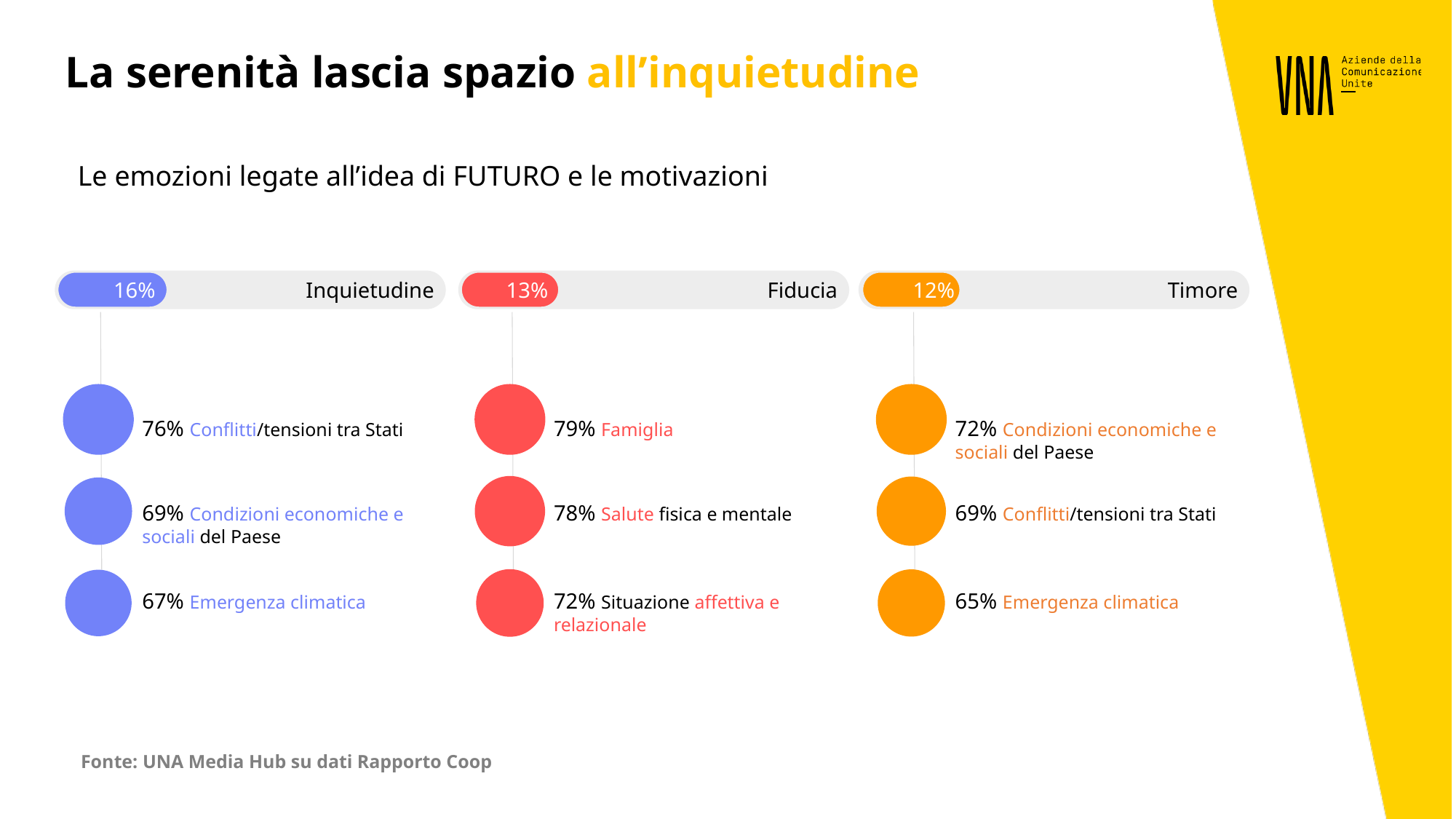
What percentage is shown for Fiducia? 13% What percentage is shown for Inquietudine? 16% Which is larger, the percentage for Fiducia or the percentage for Timore? Fiducia Which of the three emotions (Inquietudine, Fiducia, Timore) has the lowest percentage? Timore Under Inquietudine, what percentage is given for Conflitti/tensioni tra Stati? 76% How many emotions are shown in the top row of bars? 3 Under Timore, what percentage is given for Emergenza climatica? 65% What is the difference in percentage points between Emergenza climatica under Inquietudine and Emergenza climatica under Timore? 2 Which of the three emotions (Inquietudine, Fiducia, Timore) has the highest percentage? Inquietudine What percentage is shown for Timore? 12% What is the difference in percentage points between Inquietudine and Timore? 4 Under Fiducia, what percentage is given for Famiglia? 79%